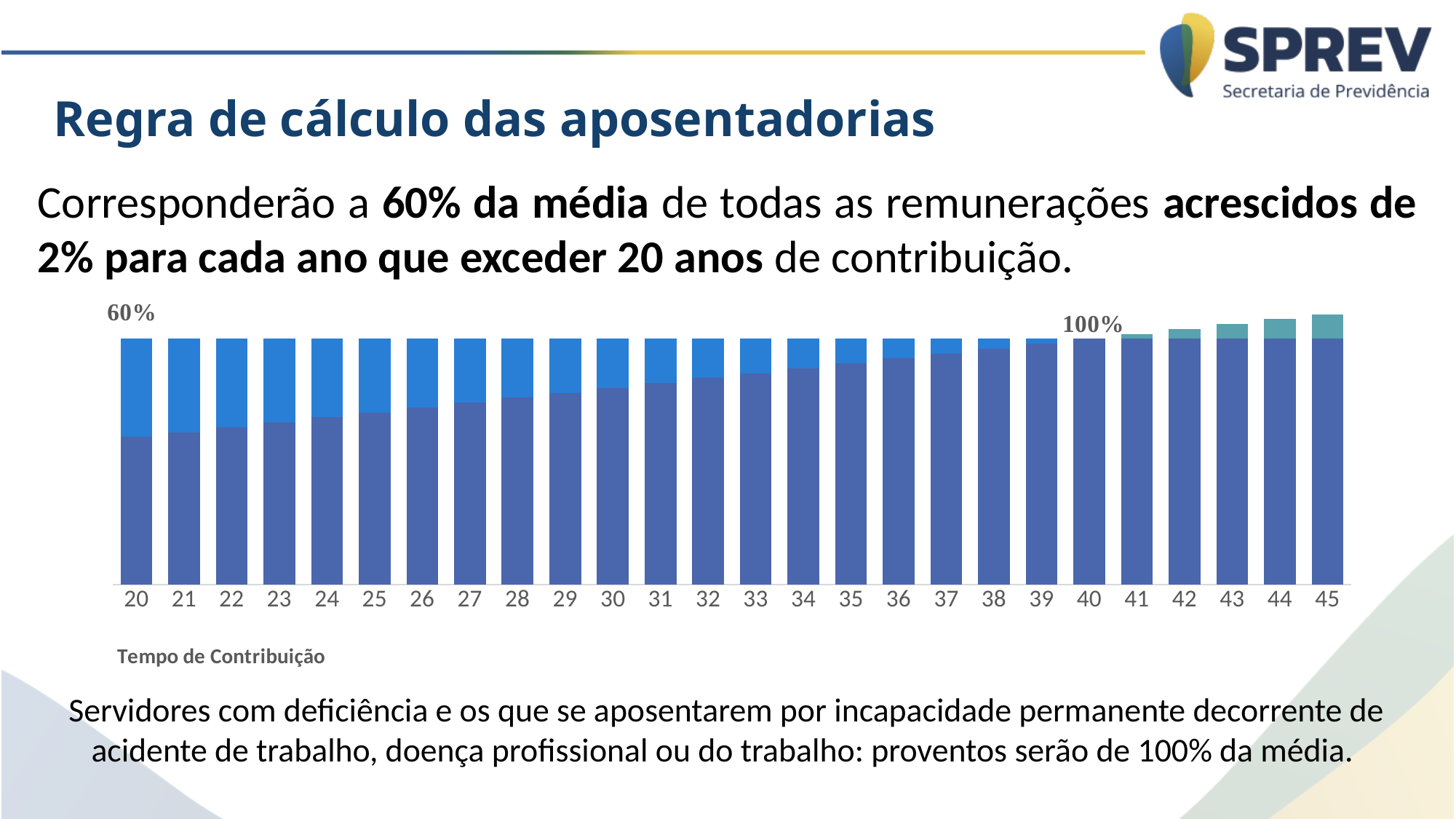
What is the x-axis title of the chart? Tempo de Contribuição What kind of chart is shown on the slide? bar chart How many contribution-time categories are shown on the x axis of the chart? 26 Which contribution time has the shortest dark blue bar? 20 How many bars in the chart have a teal segment extending above the 100% level? 5 Do the dark blue bars rise or fall as contribution time increases from 20 to 45 years? rise What value is labelled for 20 years of contribution in the chart? 60% Which has a taller dark blue bar: 25 years or 35 years of contribution? 35 What is the difference between the labelled values for 40 and 20 years of contribution? 40% What value is labelled for 40 years of contribution in the chart? 100%